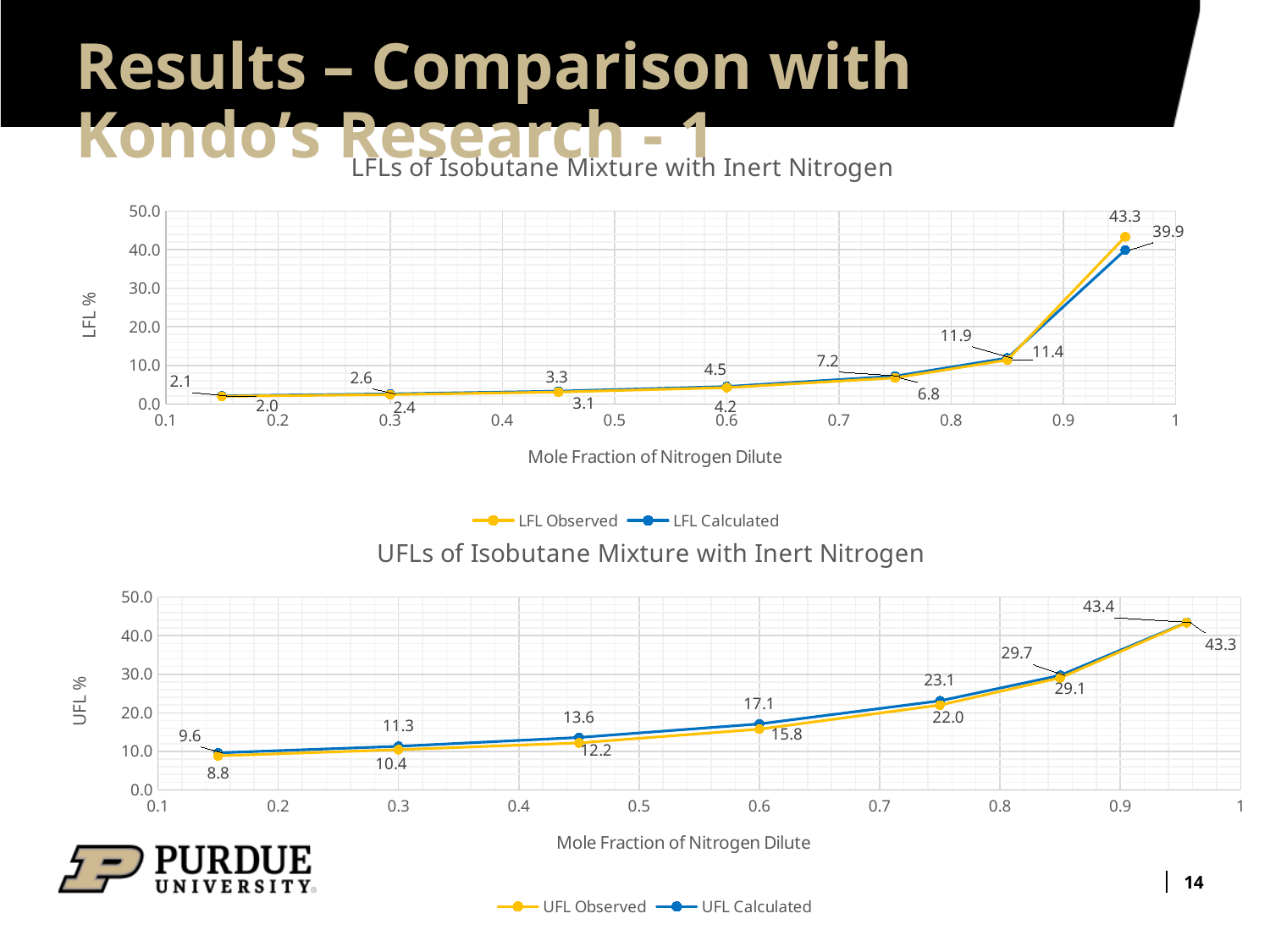
In the LFLs of Isobutane Mixture with Inert Nitrogen chart, do the LFL Observed values rise or fall as the mole fraction of nitrogen dilute increases? rise In the LFLs of Isobutane Mixture with Inert Nitrogen chart, how many data points are plotted for LFL Observed? 7 In the UFLs of Isobutane Mixture with Inert Nitrogen chart, what is the difference between the lowest UFL Calculated value and the lowest UFL Observed value? 0.8 In the UFLs of Isobutane Mixture with Inert Nitrogen chart, what is the highest value shown for UFL Calculated? 43.4 In the LFLs of Isobutane Mixture with Inert Nitrogen chart, how many series does the legend list? 2 What kind of chart is the UFLs of Isobutane Mixture with Inert Nitrogen chart? line chart In the LFLs of Isobutane Mixture with Inert Nitrogen chart, what is the highest value shown for LFL Observed? 43.3 In the UFLs of Isobutane Mixture with Inert Nitrogen chart, what is the lowest value shown for UFL Observed? 8.8 In the LFLs of Isobutane Mixture with Inert Nitrogen chart, what is the difference between the highest LFL Observed value and the highest LFL Calculated value? 3.4 In the UFLs of Isobutane Mixture with Inert Nitrogen chart, which series is drawn in blue? UFL Calculated In the LFLs of Isobutane Mixture with Inert Nitrogen chart, what is the highest value shown for LFL Calculated? 39.9 In the LFLs of Isobutane Mixture with Inert Nitrogen chart, what is the lowest value shown for LFL Calculated? 2.1